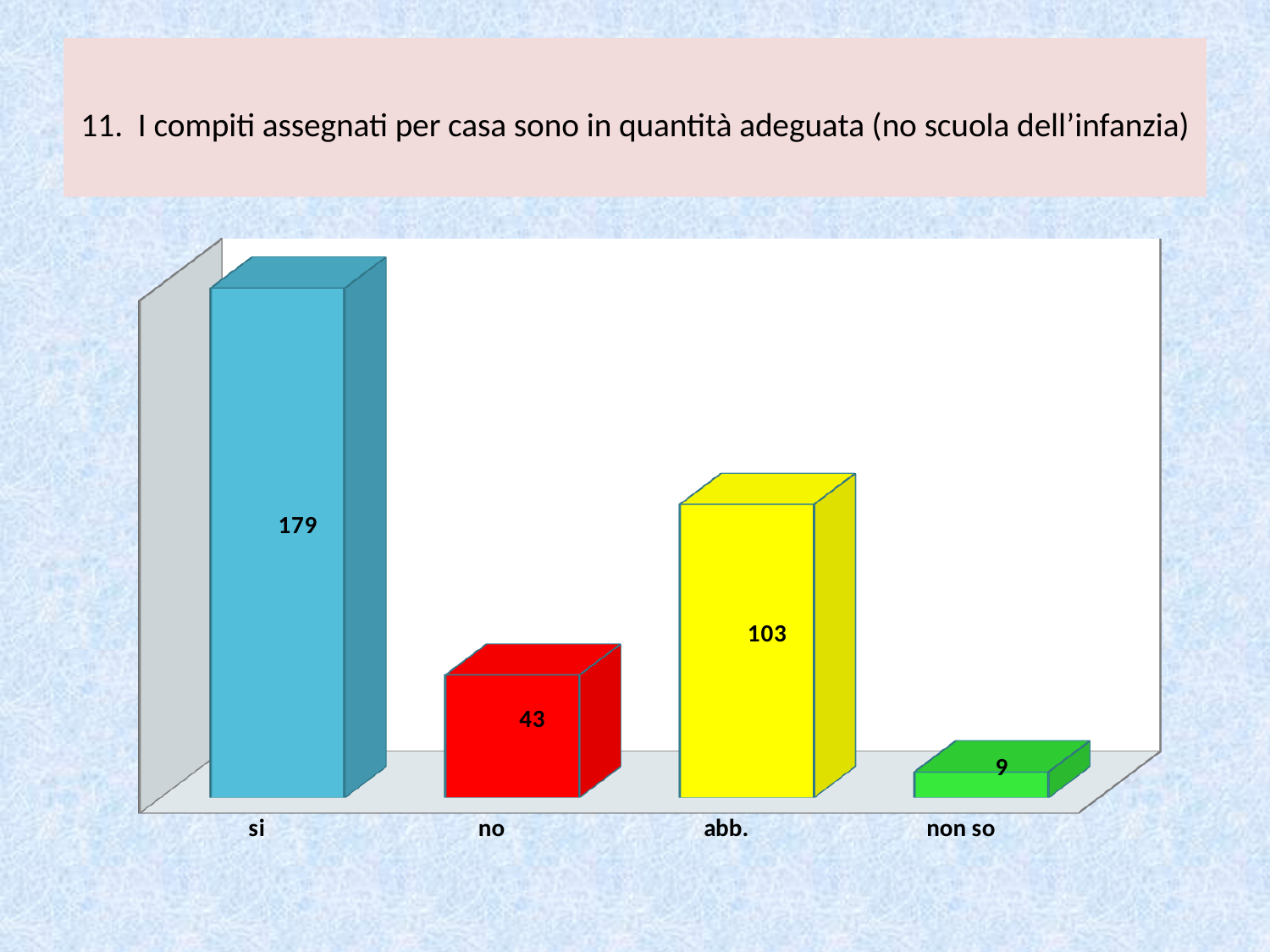
What is the difference between the values for "si" and "abb."? 76 Which category has the lowest value? non so Which category has the highest value? si What is the difference between the values for "no" and "non so"? 34 What is the value for "si"? 179 What is the value for "abb."? 103 What is the value for "non so"? 9 How many categories are shown on the x axis? 4 What is the value for "no"? 43 What colour is the bar for "abb."? yellow Which is larger, the value for "no" or the value for "abb."? abb. What kind of chart is shown on the slide? bar chart